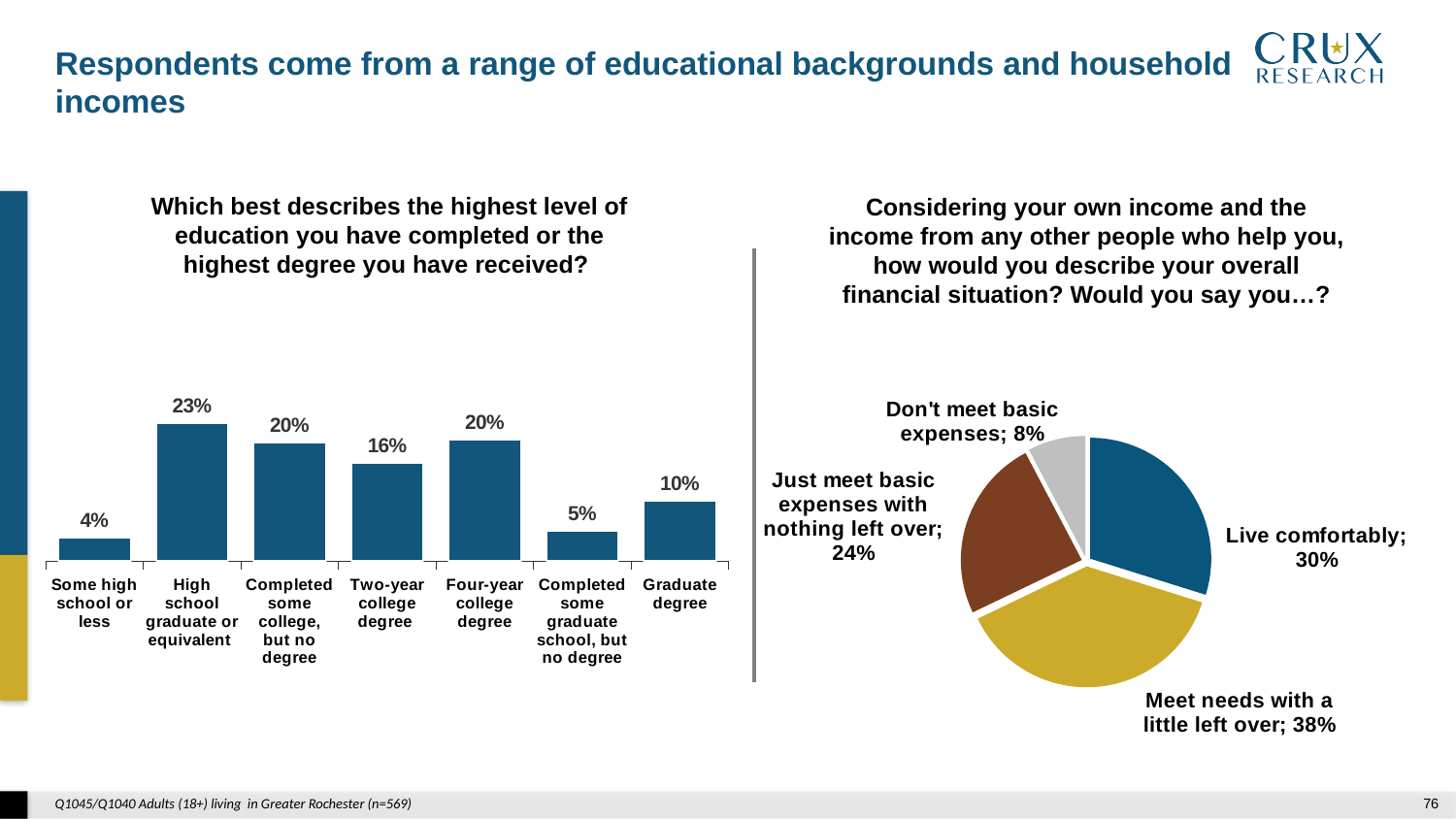
In the financial situation pie chart on the right, which category has the largest share? Meet needs with a little left over In the education chart on the left, which category has the lowest value? Some high school or less In the education chart on the left, what percentage of respondents have a graduate degree? 10% In the financial situation pie chart on the right, what is the difference between the share that 'Meet needs with a little left over' and the share that 'Don't meet basic expenses'? 30% In the education chart on the left, which is larger: the value for 'Completed some graduate school, but no degree' or the value for 'Graduate degree'? Graduate degree What type of chart is used for the financial situation question on the right? Pie chart In the education chart on the left, what percentage of respondents are high school graduates or equivalent? 23% In the education chart on the left, which category has the highest value? High school graduate or equivalent What type of chart is used for the education question on the left? Bar chart How many categories are shown in the education bar chart on the left? 7 In the financial situation pie chart on the right, what share of respondents say they 'Live comfortably'? 30% In the education chart on the left, what is the difference between the percentage with a four-year college degree and the percentage with a two-year college degree? 4%